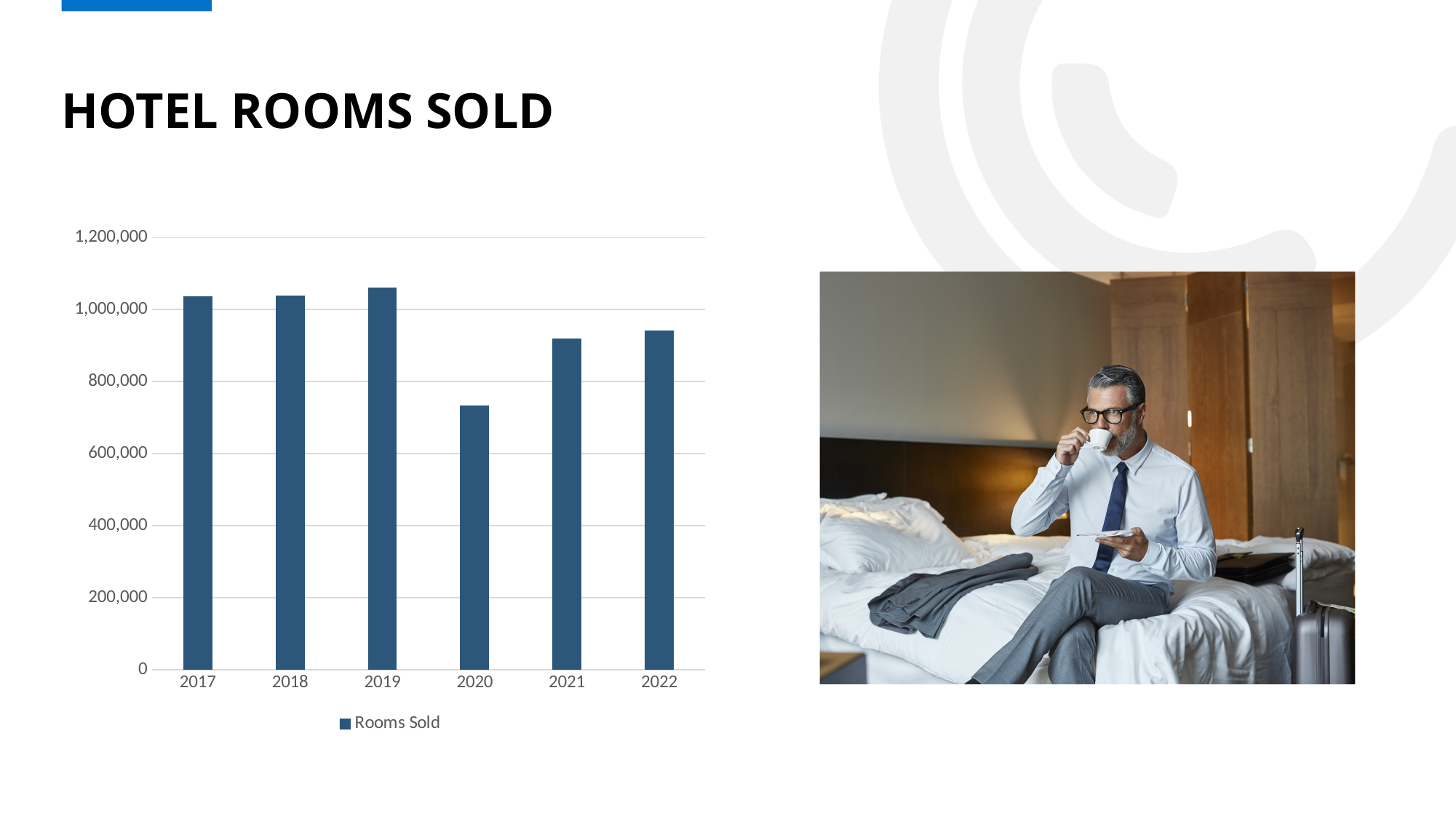
Did the number of rooms sold rise or fall from 2019 to 2020? fall Which year has the lowest number of rooms sold? 2020 Is the value for 2020 greater or less than 800,000? less Which year has more rooms sold, 2020 or 2021? 2021 How many years are shown on the x axis of the chart? 6 Is the value for 2022 greater or less than 1,000,000? less Which year has more rooms sold, 2017 or 2022? 2017 What is the name of the series shown in the chart's legend? Rooms Sold Is the value for 2019 greater or less than 1,000,000? greater What kind of chart is shown on the slide? bar chart How many series does the chart's legend list? 1